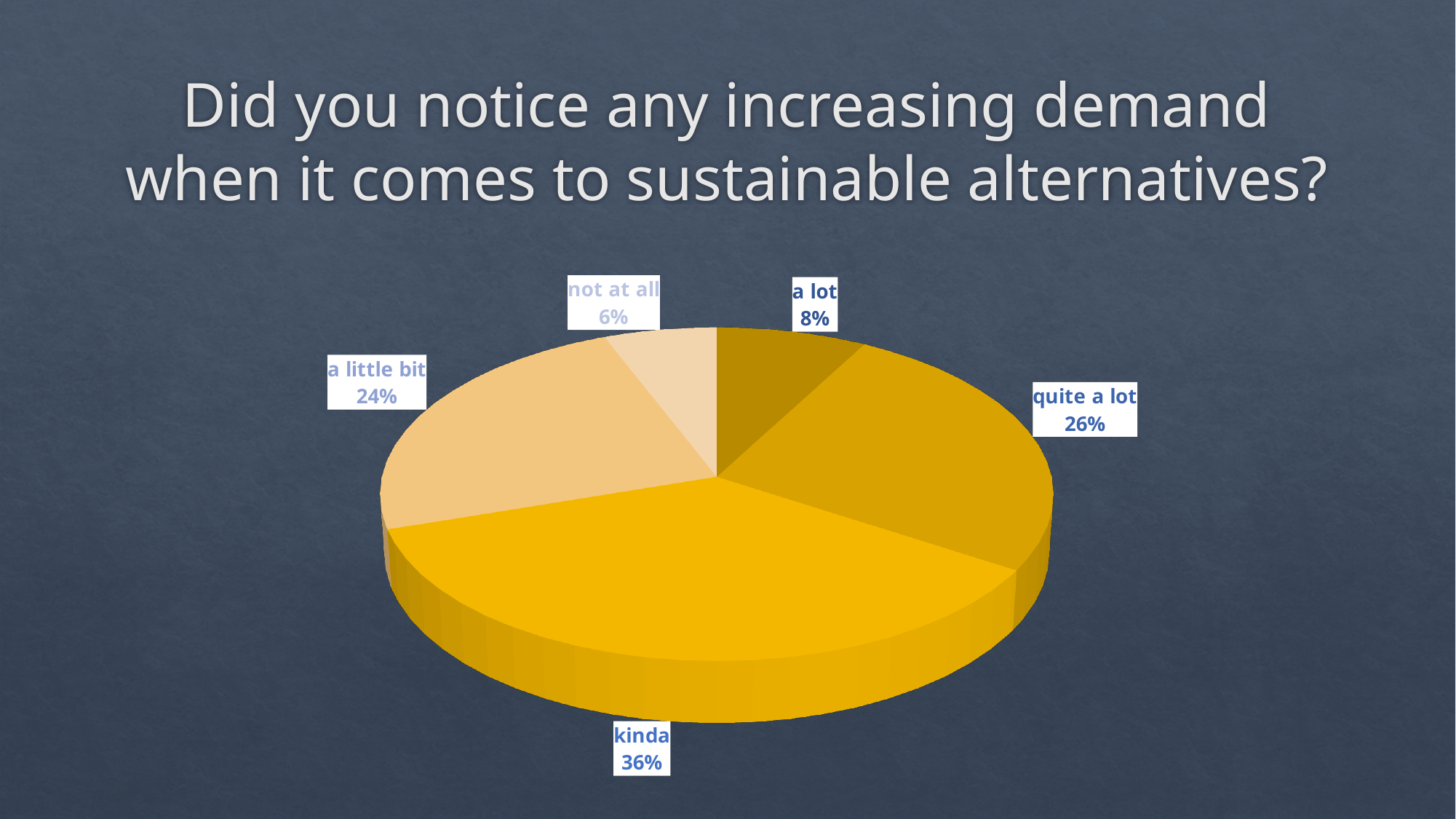
What share of respondents answered "a lot"? 8% What is the title of the chart on the slide? Did you notice any increasing demand when it comes to sustainable alternatives? How many response categories are shown in the pie chart? 5 Which response has the largest slice of the pie? kinda What share of respondents answered "kinda"? 36% What kind of chart is shown on the slide? pie chart Which is larger, the share for "a lot" or the share for "not at all"? a lot What is the difference in percentage points between "kinda" and "quite a lot"? 10 What share of respondents answered "a little bit"? 24% Which response has the smallest slice of the pie? not at all